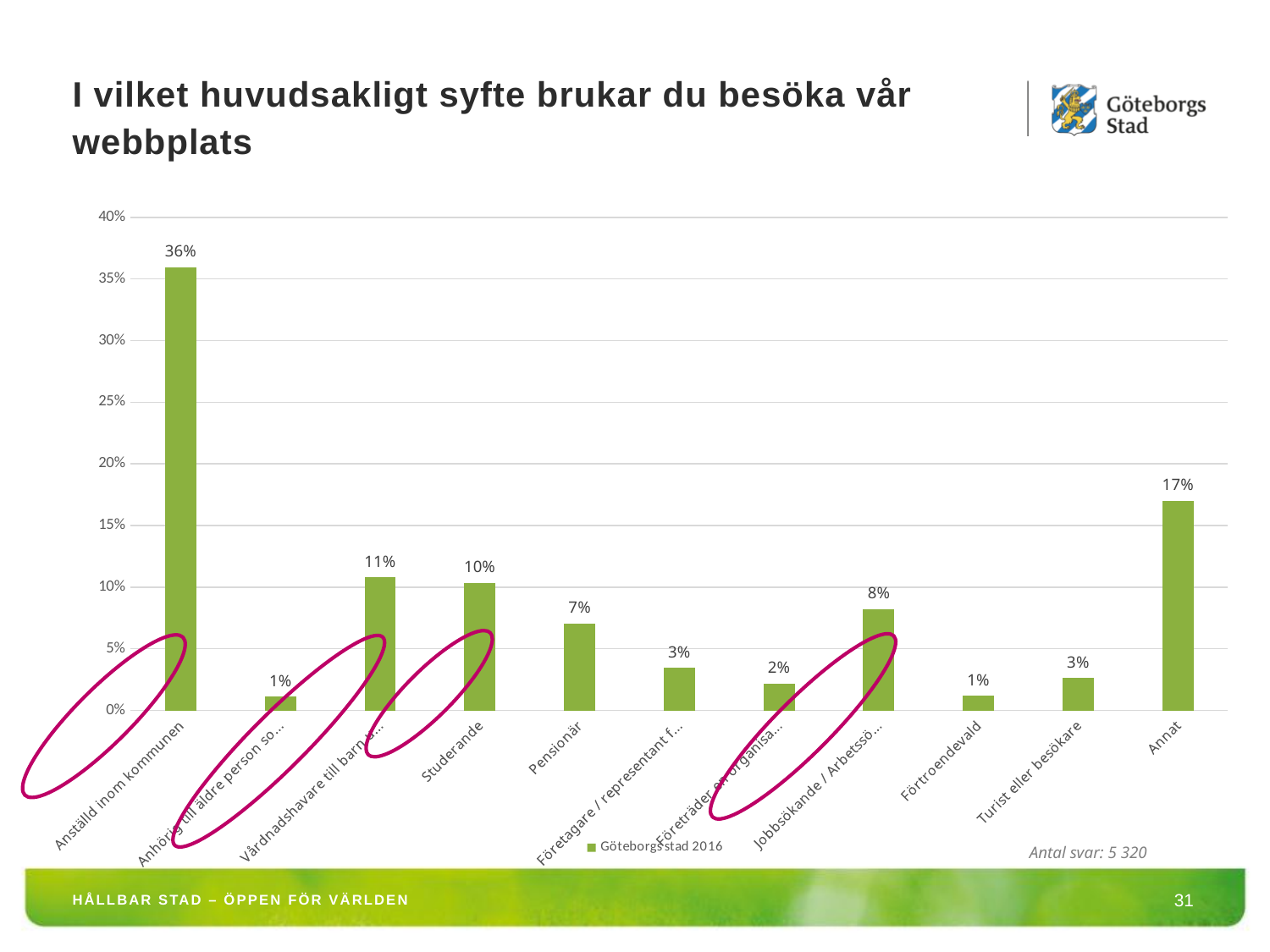
What is the value for Anställd inom kommunen? 36% What is the value for Förtroendevald? 1% Is the value for Annat greater or less than 15%? greater Which is larger, the value for Studerande or the value for Pensionär? Studerande What is the value for Studerande? 10% What is the value for Pensionär? 7% How many categories are shown on the x axis? 11 Which category has the highest value? Anställd inom kommunen What is the value for Annat? 17% What is the difference between the values for Anställd inom kommunen and Annat? 19% What kind of chart is shown on the slide? bar chart What series name does the legend show? Göteborgs stad 2016